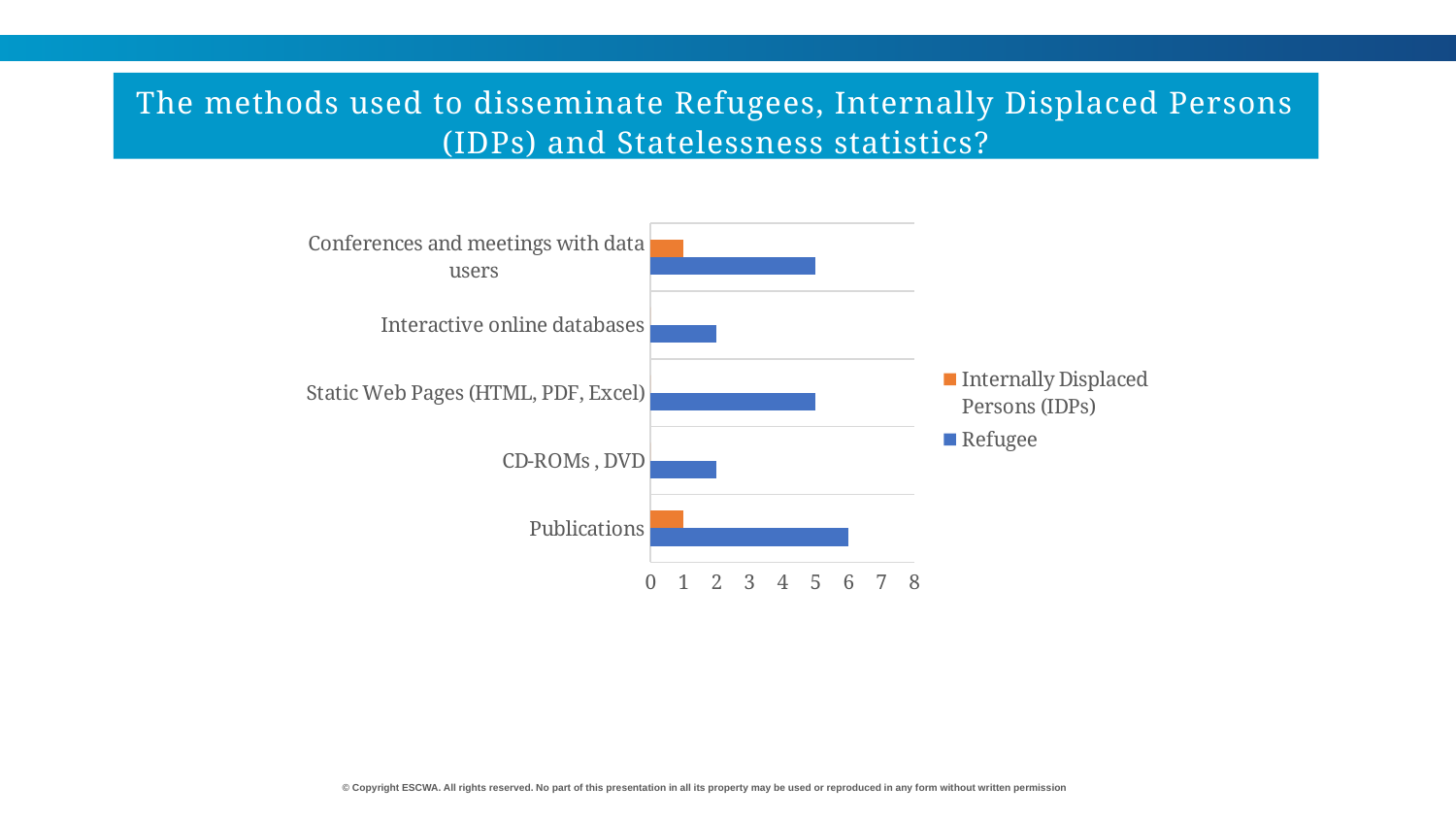
How many dissemination methods (categories) are shown on the chart? 5 Which dissemination method has the highest Refugee value? Publications Which is larger for Refugee: Conferences and meetings with data users or CD-ROMs, DVD? Conferences and meetings with data users What kind of chart is shown on the slide? Bar chart What is the Refugee value for Static Web Pages (HTML, PDF, Excel)? 5 What is the difference between the Refugee and Internally Displaced Persons (IDPs) values for Publications? 5 Which colour represents the Refugee series in the legend? Blue What is the Internally Displaced Persons (IDPs) value for Conferences and meetings with data users? 1 How many series does the legend list? 2 Is the Refugee value for Publications greater or less than 4? greater What is the Refugee value for Interactive online databases? 2 What is the Refugee value for Publications? 6